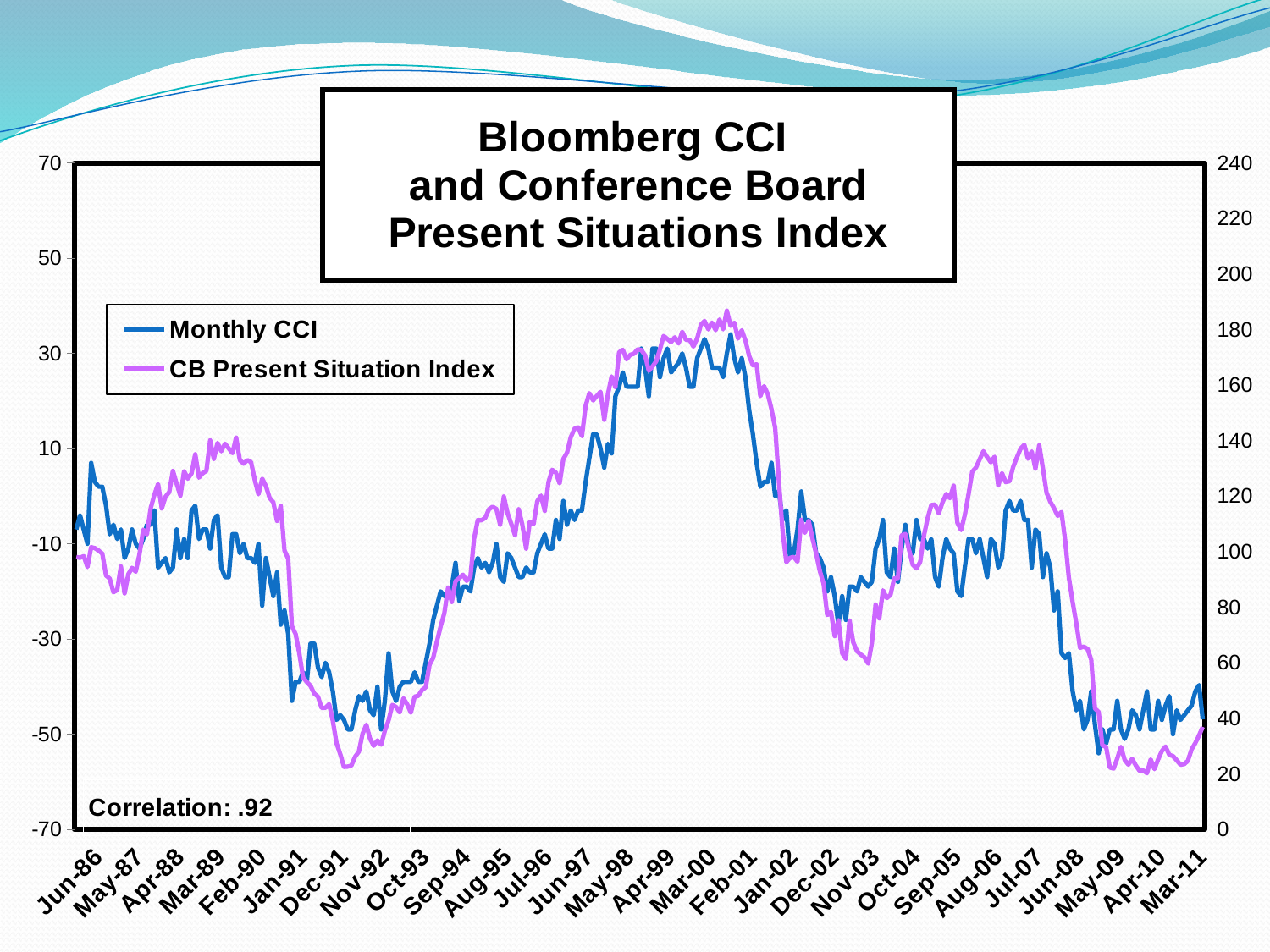
Is the Monthly CCI value at Mar-11 greater or less than -30? less What correlation value is printed on the chart? .92 Between Jul-07 and May-09, does the CB Present Situation Index line generally rise or fall? fall Is the CB Present Situation Index value around Dec-91 greater or less than 60 on the right axis? less How many series does the legend list? 2 What kind of chart is shown on the slide? line chart Is the Monthly CCI value around Mar-00 greater or less than 10? greater What are the two series named in the legend? Monthly CCI and CB Present Situation Index Between Dec-91 and Mar-00, does the Monthly CCI line generally rise or fall? rise